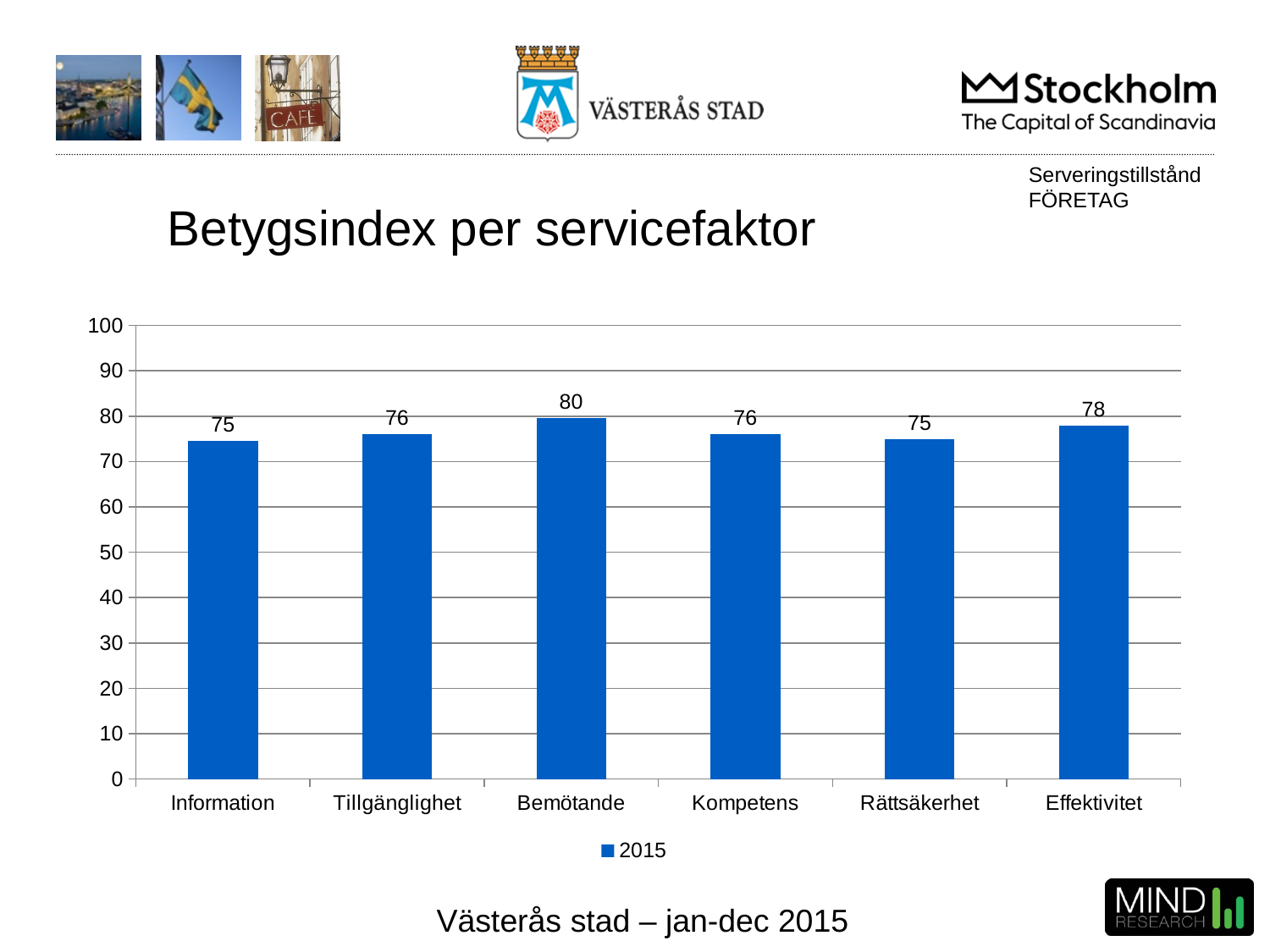
Which is larger, the value for Effektivitet or the value for Kompetens? Effektivitet What kind of chart is shown? bar chart How many series does the legend list? 1 How many service factors are shown on the x axis? 6 Which service factor has the highest value? Bemötande What is the value for Information? 75 What is the difference between the values for Bemötande and Rättsäkerhet? 5 What series name is shown in the legend? 2015 What is the title of the chart? Betygsindex per servicefaktor Is the value for Tillgänglighet greater or less than 70? greater What is the value for Bemötande? 80 What is the value for Effektivitet? 78